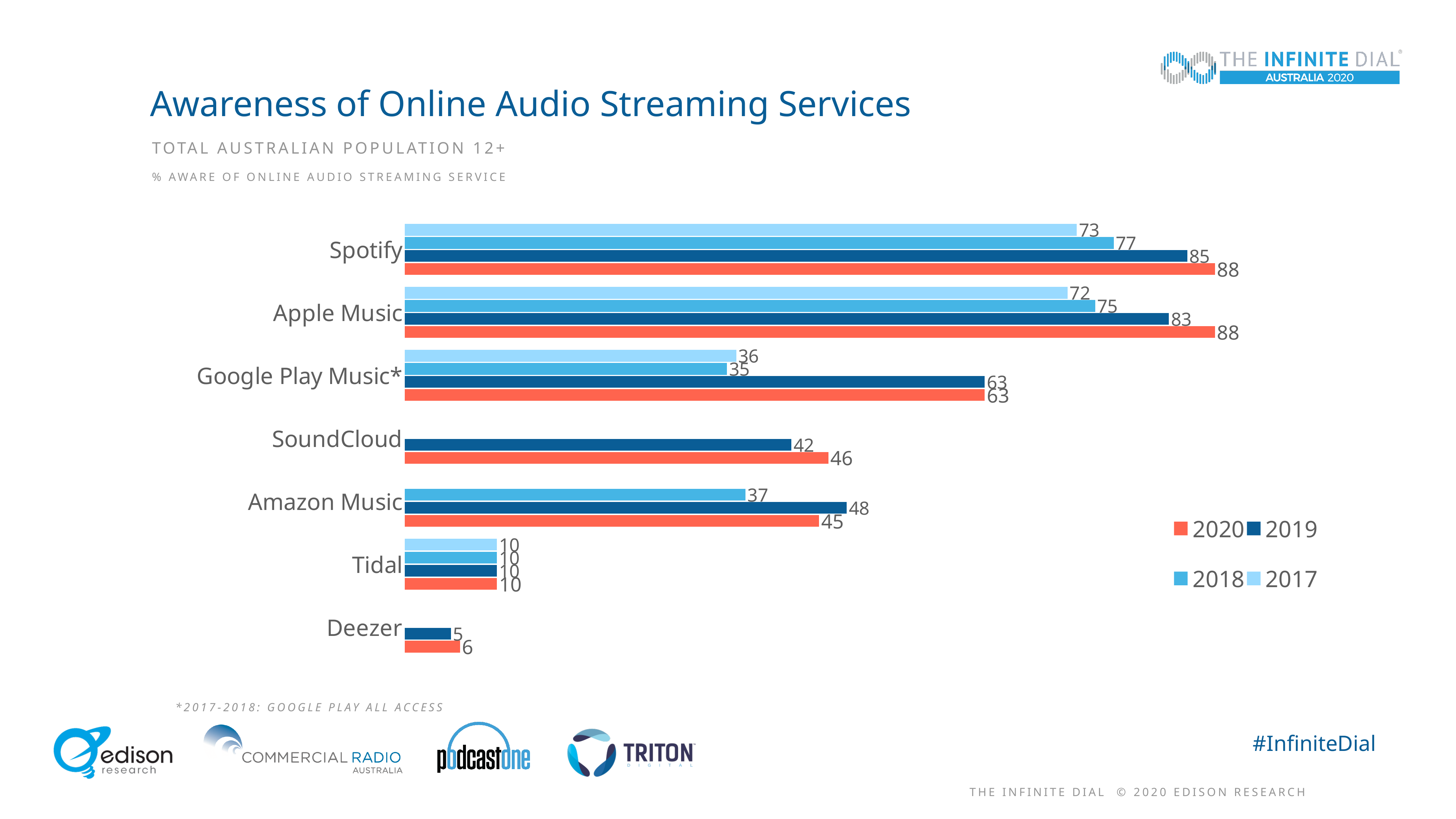
Which is larger, the 2020 value for SoundCloud or the 2020 value for Amazon Music? SoundCloud What is the difference between the 2019 and 2020 values for Amazon Music? 3 How many series does the legend list? 4 What is the 2017 value for Apple Music? 72 What is the difference between the 2018 and 2019 values for Google Play Music*? 28 What is the 2019 value for SoundCloud? 42 What is the 2018 value for Google Play Music*? 35 What kind of chart is shown on the slide? Bar chart Which colour represents the 2020 series in the legend? Orange-red Which service has the lowest 2020 value? Deezer What is the 2020 value for Spotify? 88 How many services are listed on the chart? 7